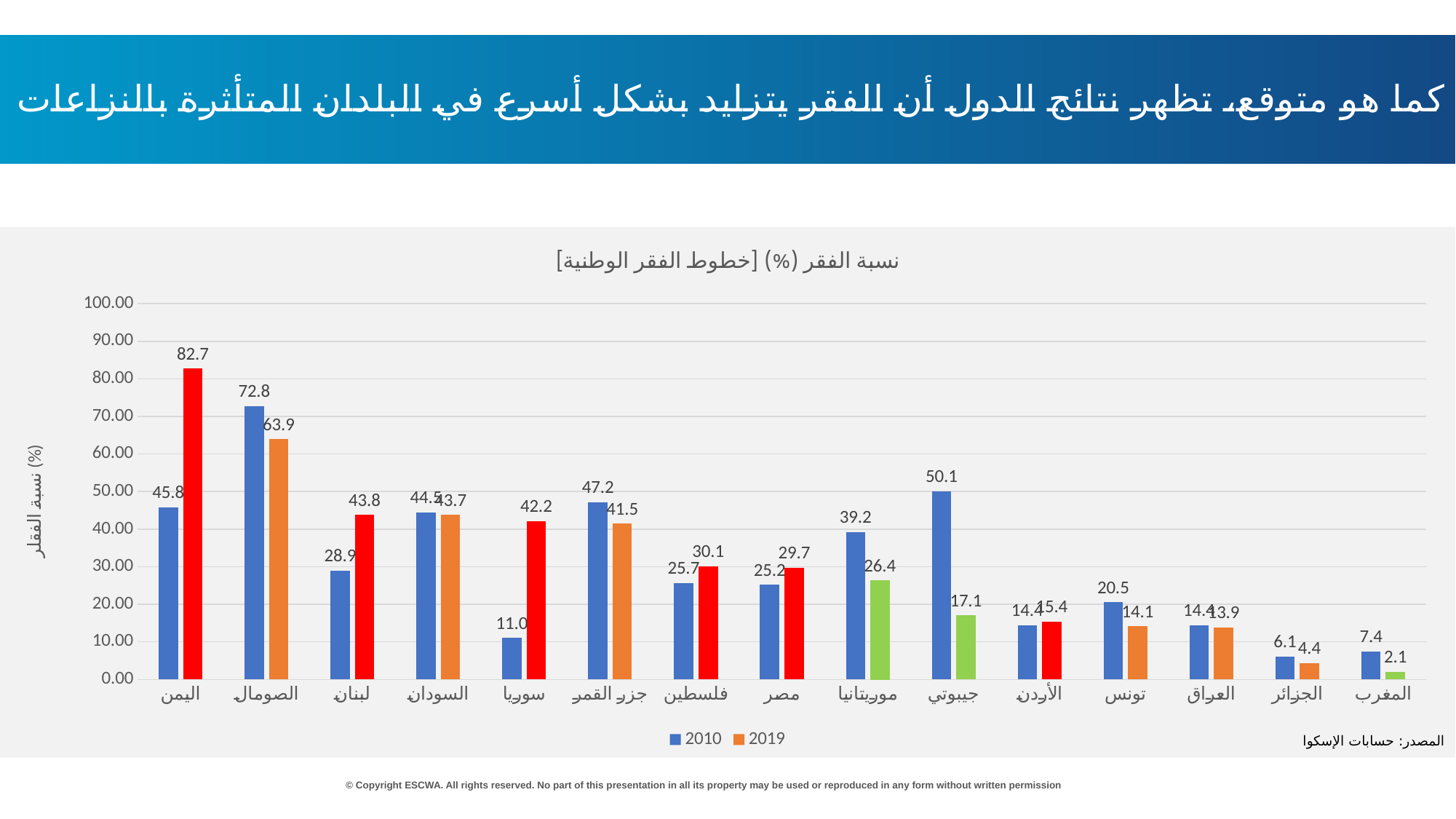
What is the 2019 value for اليمن? 82.7 What is the 2010 value for الصومال? 72.8 What is the 2019 value for موريتانيا? 26.4 How many categories are shown on the x axis? 15 What kind of chart is shown on the slide? bar chart What is the difference between the 2019 and 2010 values for لبنان? 14.9 Which is larger for جيبوتي, the 2010 value or the 2019 value? 2010 Which category has the highest 2019 value? اليمن What is the 2010 value for سوريا? 11.0 Which category has the lowest 2019 value? المغرب Is the 2010 value for جزر القمر greater or less than 40.00? greater How many series does the legend list? 2